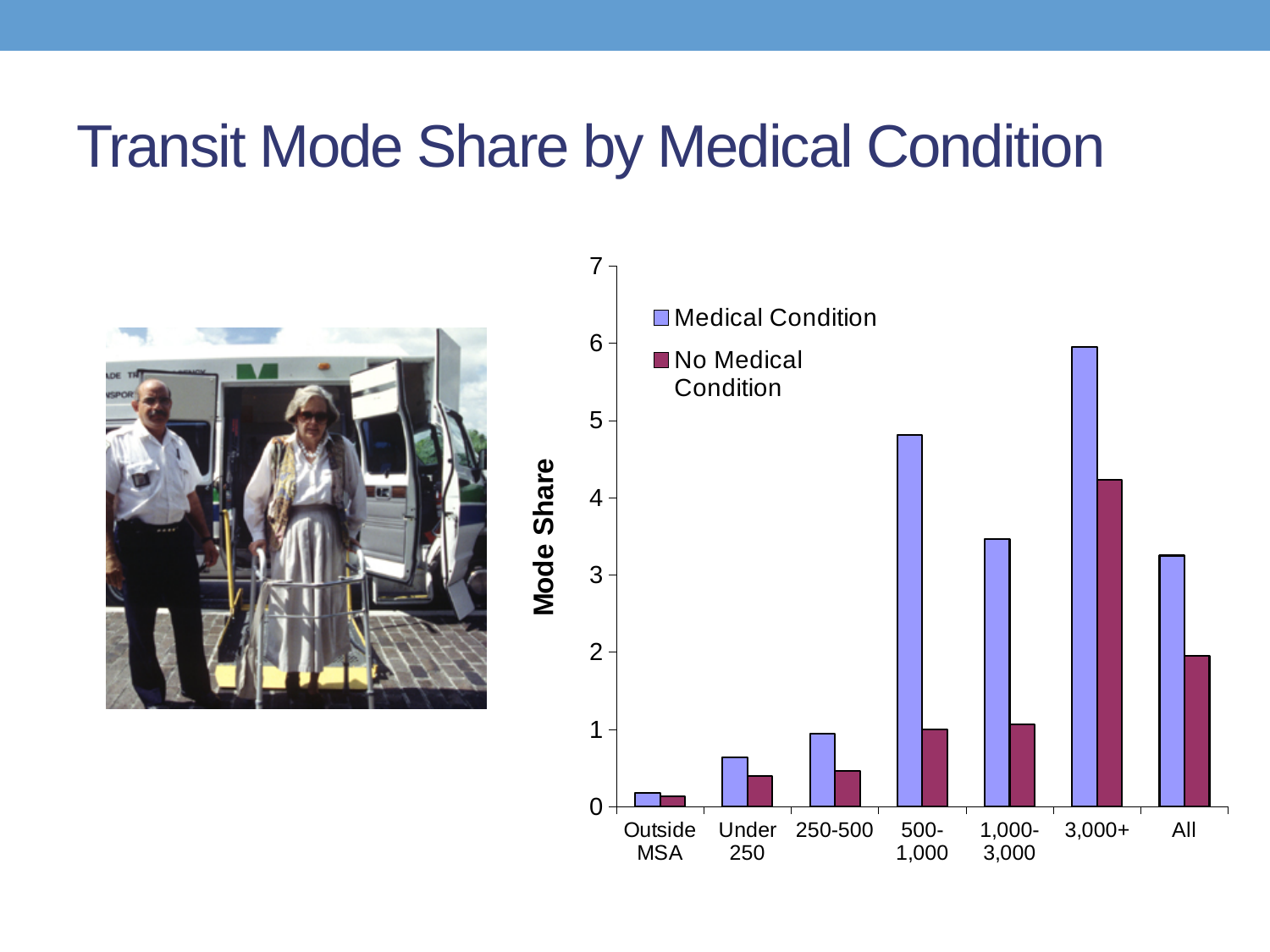
How many series does the legend list? 2 Is the Medical Condition value for 3,000+ greater or less than 5? greater Is the Medical Condition value for 500-1,000 greater or less than 4? greater For the 500-1,000 category, which series has the larger value, Medical Condition or No Medical Condition? Medical Condition Which category has the highest Medical Condition value? 3,000+ What kind of chart is shown on the slide? bar chart How many categories are shown on the x axis? 7 Which category has the lowest Medical Condition value? Outside MSA Which category has the highest No Medical Condition value? 3,000+ Is the No Medical Condition value for Under 250 greater or less than 1? less What is the label on the vertical axis? Mode Share